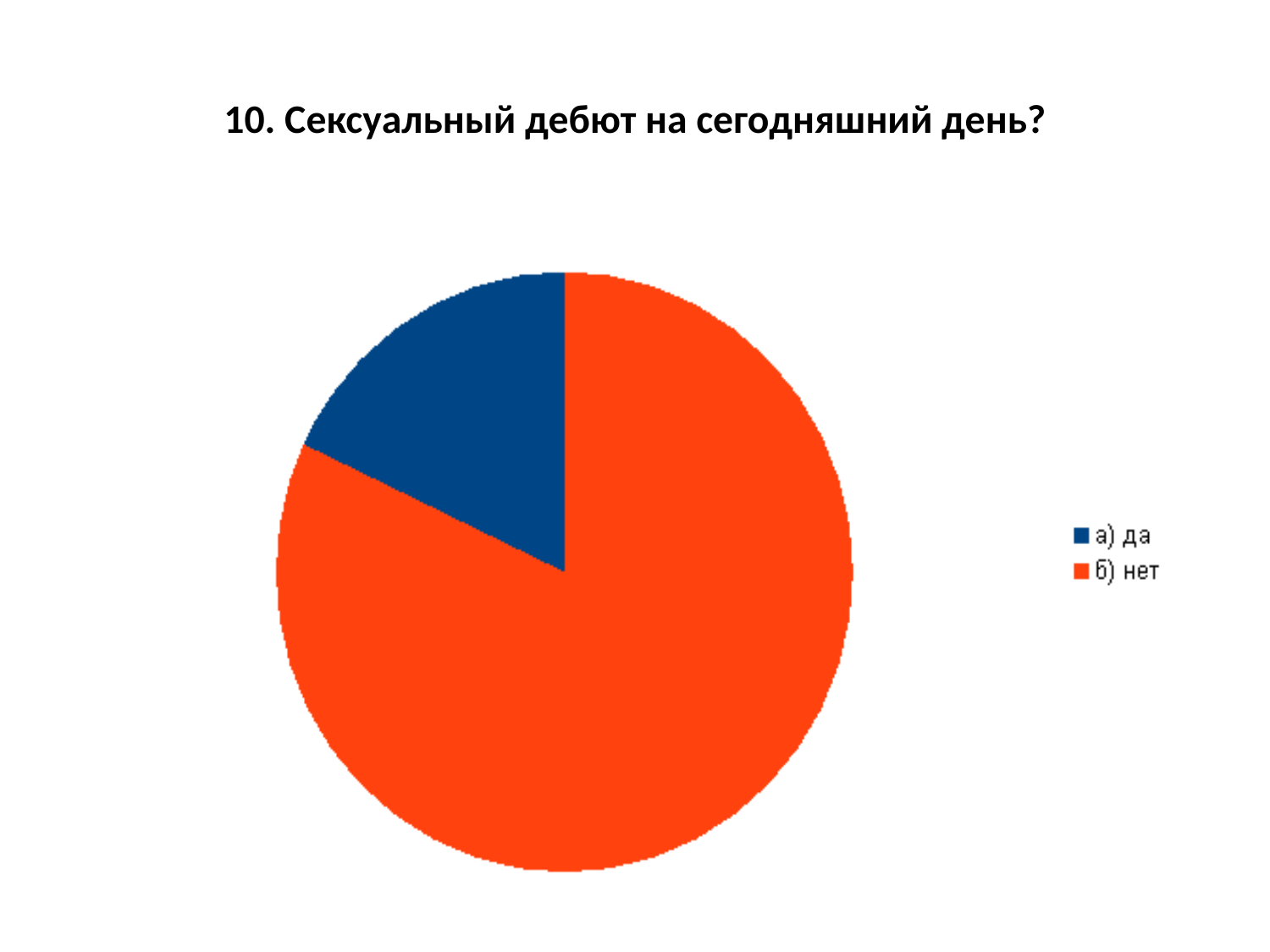
What is the title of the slide with the pie chart? 10. Сексуальный дебют на сегодняшний день? How many entries does the legend of the pie chart list? 2 Which category has the largest slice in the pie chart? б) нет Which slice is larger in the pie chart, "а) да" or "б) нет"? б) нет What colour is the slice for "а) да" in the pie chart? blue Which category has the smallest slice in the pie chart? а) да What kind of chart is shown on the slide? pie chart How many slices does the pie chart have? 2